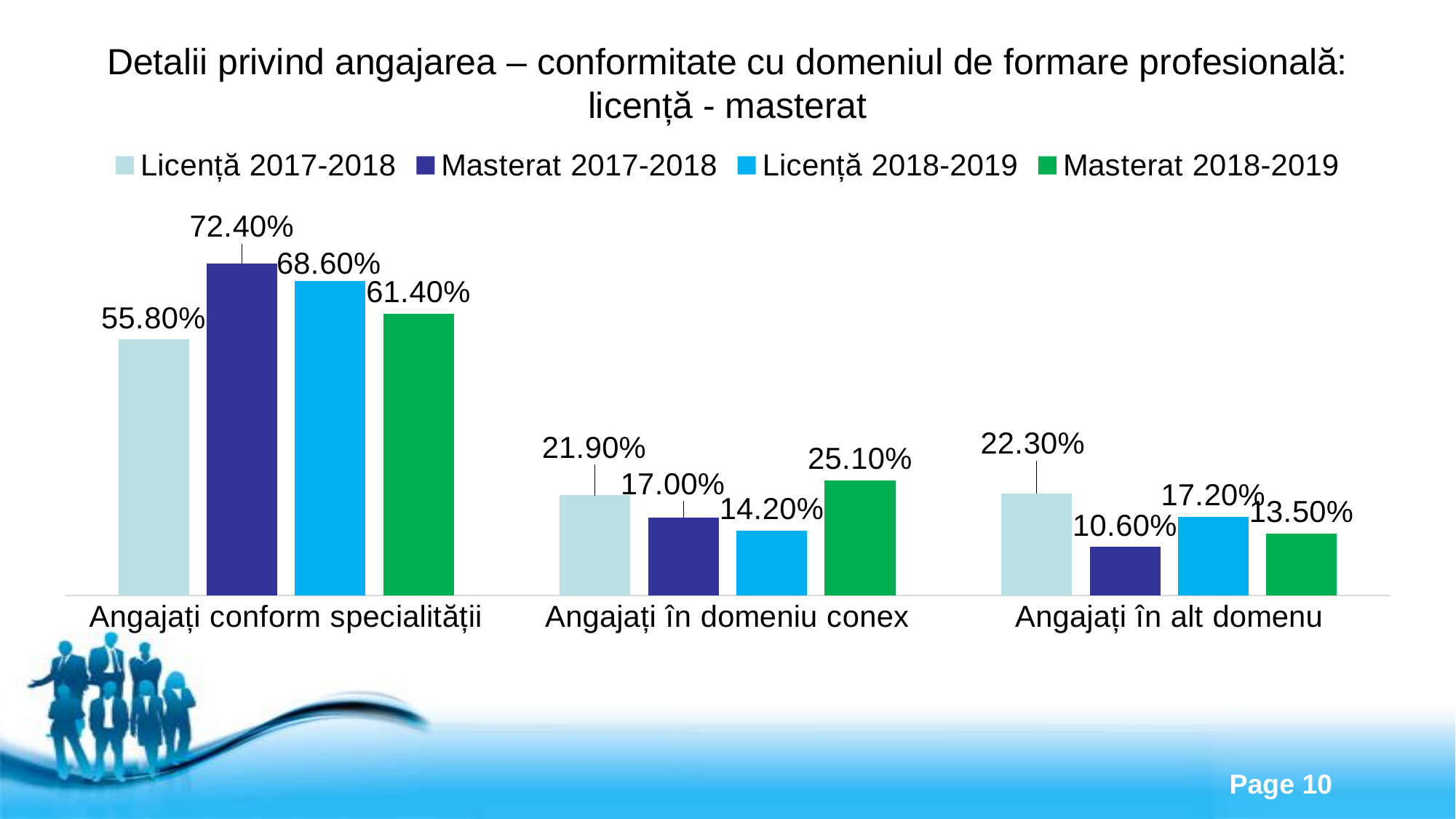
What is the value for Licență 2017-2018 in the 'Angajați în alt domenu' category? 22.30% In the 'Angajați în domeniu conex' category, which is larger: Licență 2017-2018 or Masterat 2018-2019? Masterat 2018-2019 What kind of chart is shown on the slide? Bar chart What is the difference between the Masterat 2017-2018 and Licență 2017-2018 values in the 'Angajați conform specialității' category? 16.60% How many series does the legend list? 4 Which series has the lowest value in the 'Angajați în alt domenu' category? Masterat 2017-2018 Which colour represents the Masterat 2018-2019 series in the legend? Green What is the value for Licență 2018-2019 in the 'Angajați în domeniu conex' category? 14.20% Which series has the highest value in the 'Angajați conform specialității' category? Masterat 2017-2018 What is the value for Masterat 2017-2018 in the 'Angajați conform specialității' category? 72.40% How many categories are shown on the x axis? 3 What is the value for Masterat 2018-2019 in the 'Angajați în alt domenu' category? 13.50%